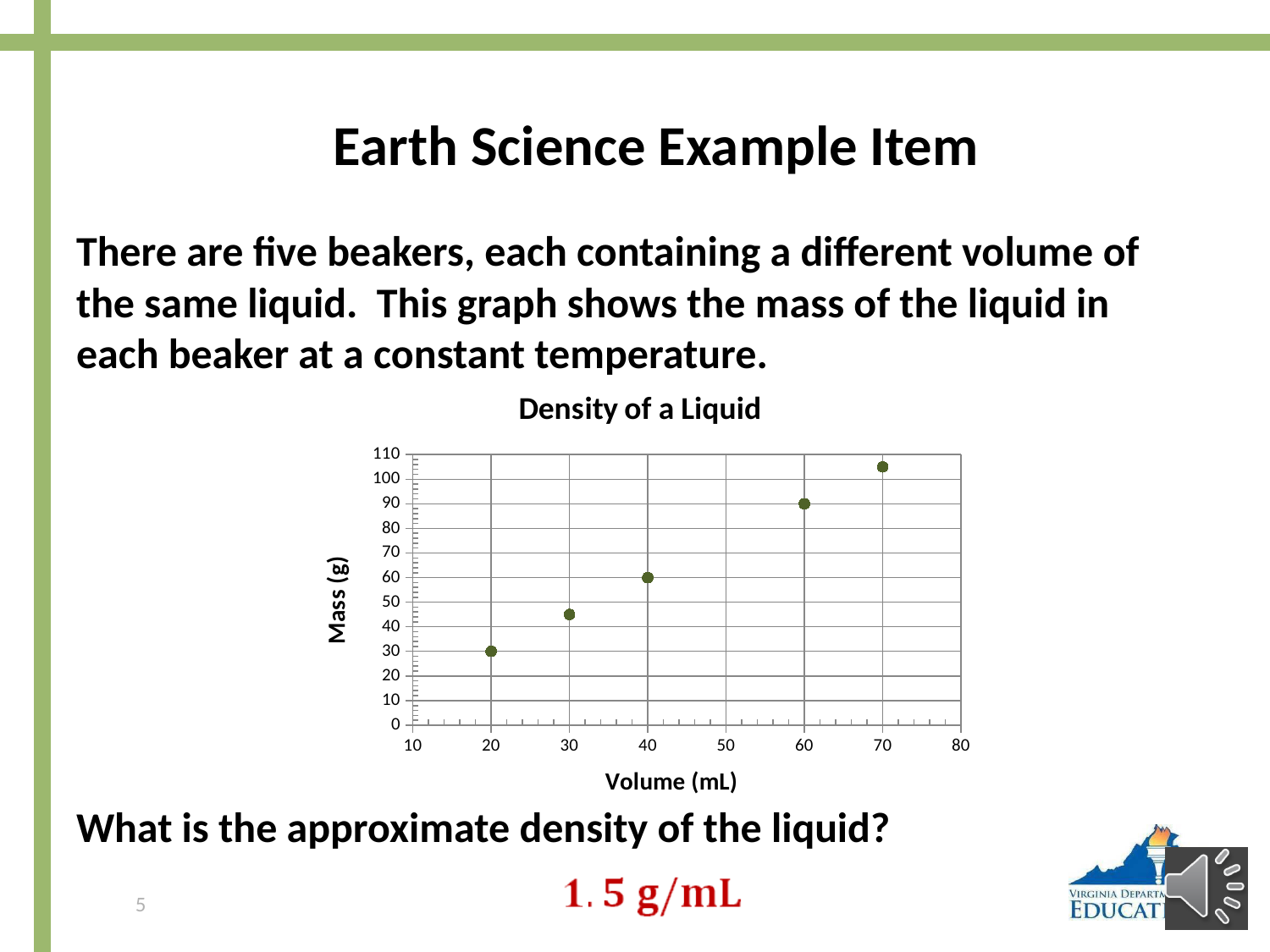
Is the mass at a volume of 30 mL greater or less than 50? less What is the mass at a volume of 60 mL? 90 What is the label of the y axis of the chart? Mass (g) What is the mass at a volume of 40 mL? 60 At which volume is the mass lowest? 20 What type of chart is shown on the slide? scatter plot How many data points are plotted on the chart? 5 At which volume is the mass highest? 70 What is the title of the chart? Density of a Liquid What is the mass at a volume of 20 mL? 30 Is the mass at a volume of 70 mL greater or less than 100? greater What is the difference in mass between the points at 60 mL and 40 mL? 30